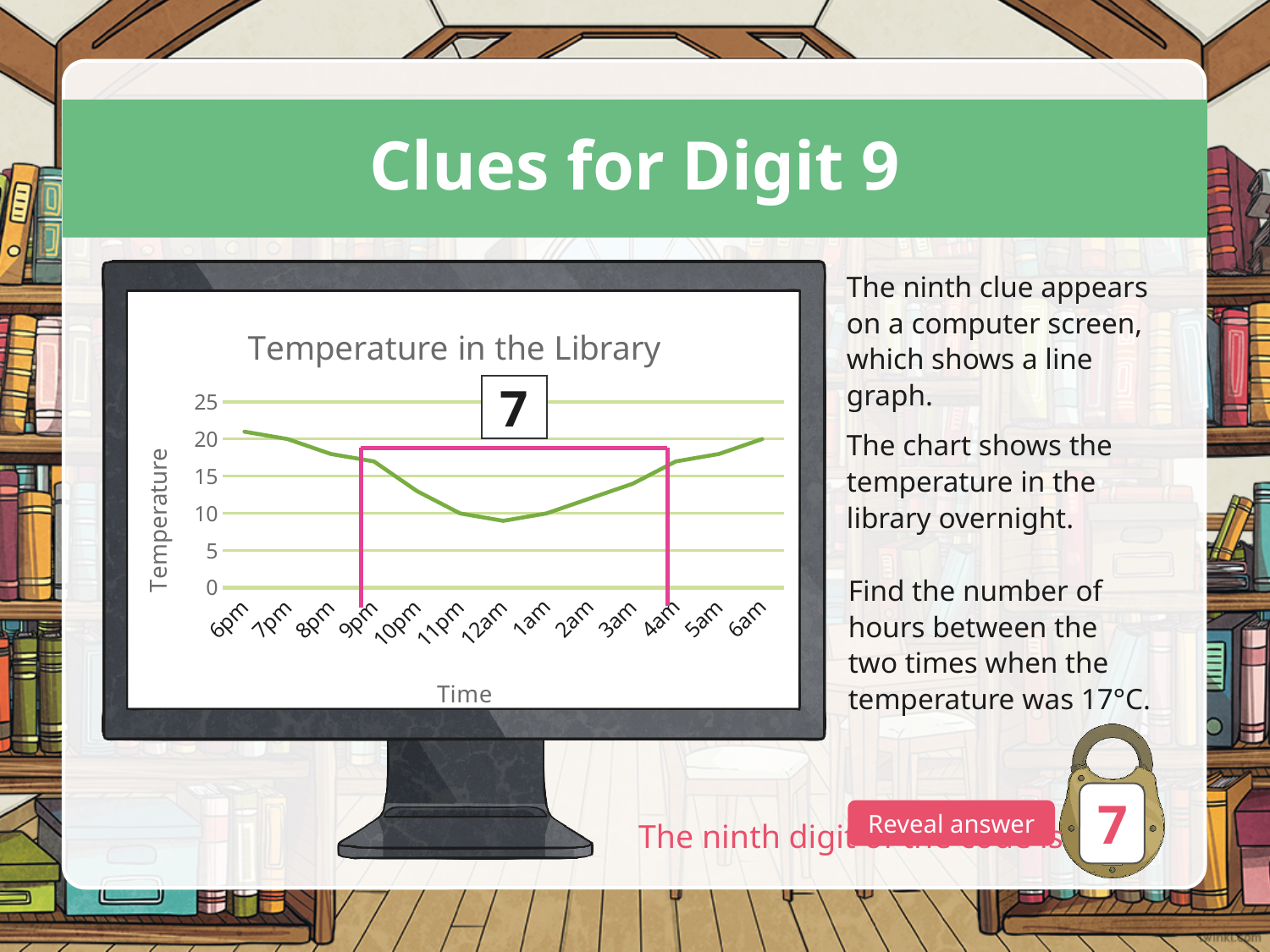
What is the label on the y axis of the chart? Temperature How many time points are plotted along the x axis of the chart? 13 What is the title of the chart? Temperature in the Library At which time is the temperature lowest on the chart? 12am Does the temperature rise or fall from 6pm to 12am? fall Which has the higher temperature, 6pm or 12am? 6pm Is the temperature at 6pm greater or less than 20? greater Is the temperature at 2am greater or less than 15? less Is the temperature at 12am greater or less than 10? less What kind of chart is shown on the computer screen? line chart